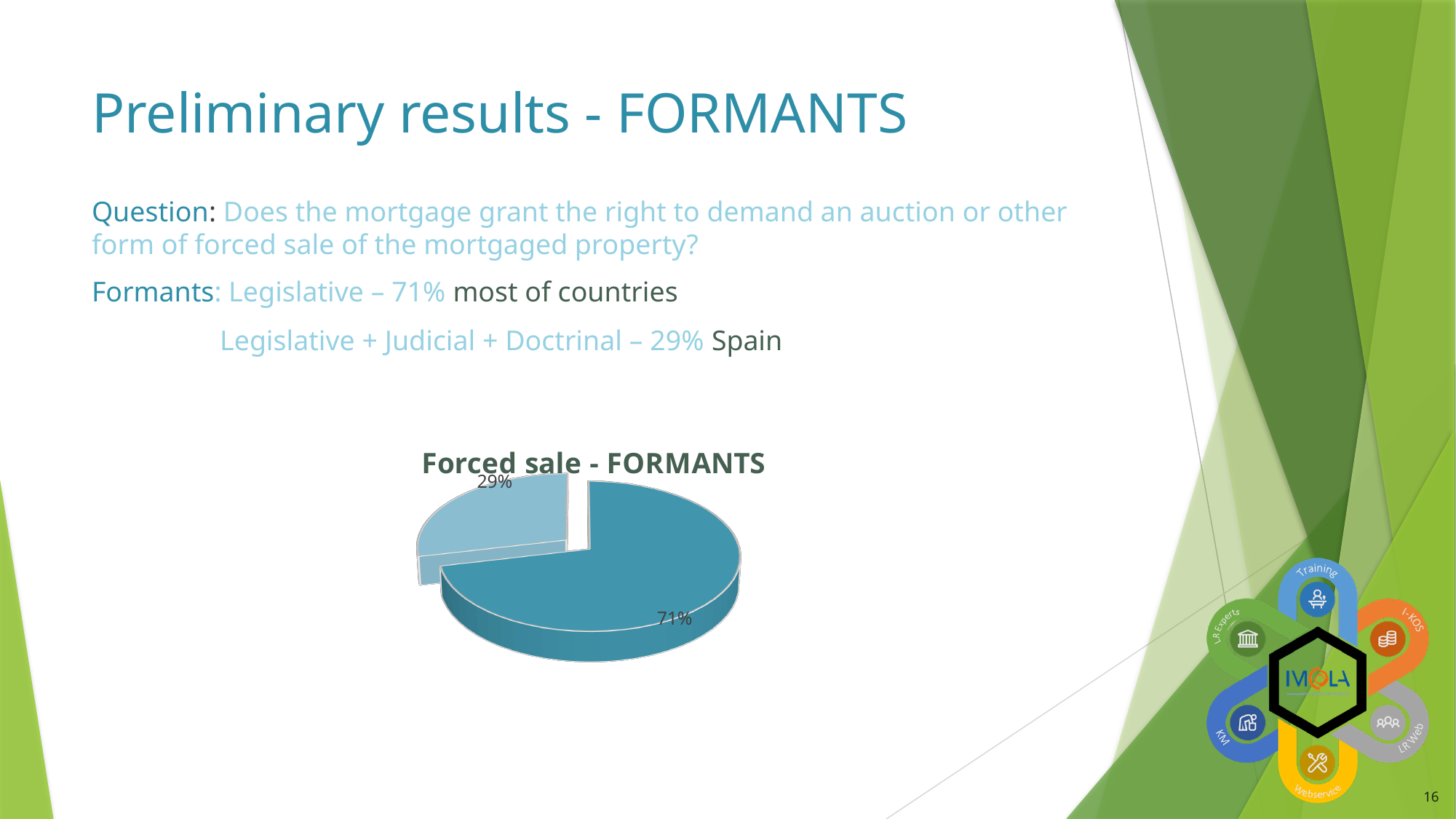
What is the title of the chart on the slide? Forced sale - FORMANTS What kind of chart is shown under the title "Forced sale - FORMANTS"? pie chart According to the slide text, what share of the pie chart corresponds to the Legislative formant? 71% How many slices does the pie chart have? 2 Is the value of the larger slice of the pie chart greater or less than 50%? greater According to the slide text, what share of the pie chart corresponds to Legislative + Judicial + Doctrinal (Spain)? 29% What is the difference in percentage points between the two slices of the pie chart? 42 Is the smaller slice of the pie chart pulled out (exploded) from the rest of the pie? yes What percentage is shown on the smaller, lighter-coloured slice of the pie chart? 29% What is the total of the two percentages shown on the pie chart? 100% Which slice of the pie chart is larger, the one labelled 71% or the one labelled 29%? 71% What percentage is shown on the larger slice of the pie chart? 71%